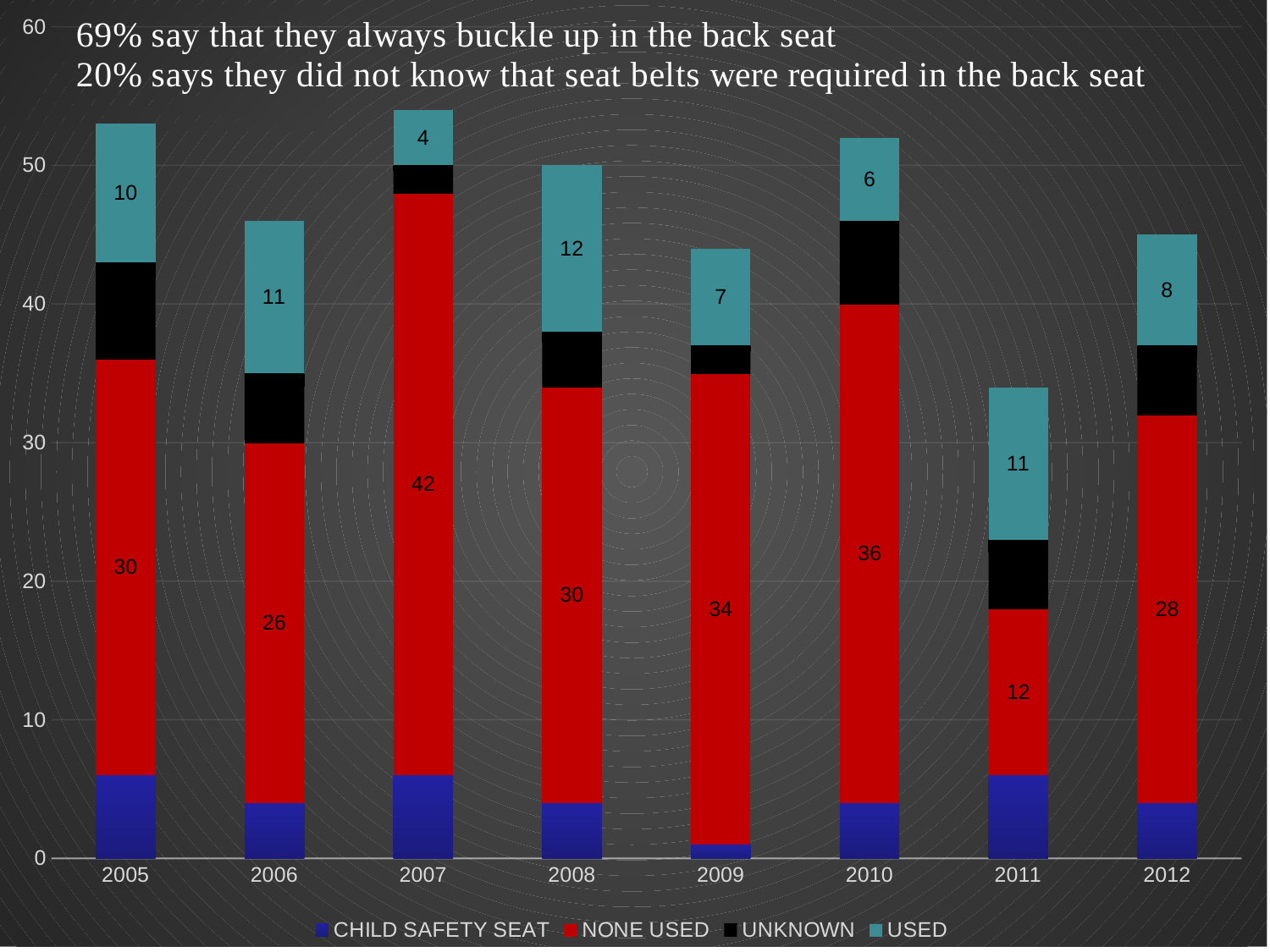
What is the NONE USED value for 2011? 12 Which year has the lowest USED value? 2007 What is the NONE USED value for 2007? 42 Which is larger, the NONE USED value for 2009 or for 2010? 2010 How many years are shown on the x axis? 8 How many series does the legend list? 4 What is the difference between the NONE USED values for 2007 and 2011? 30 Which year has the highest NONE USED value? 2007 What is the USED value for 2008? 12 What kind of chart is shown on the slide? Stacked bar chart Is the total height of the 2011 bar greater or less than 40? less Is the total height of the 2007 bar greater or less than 50? greater